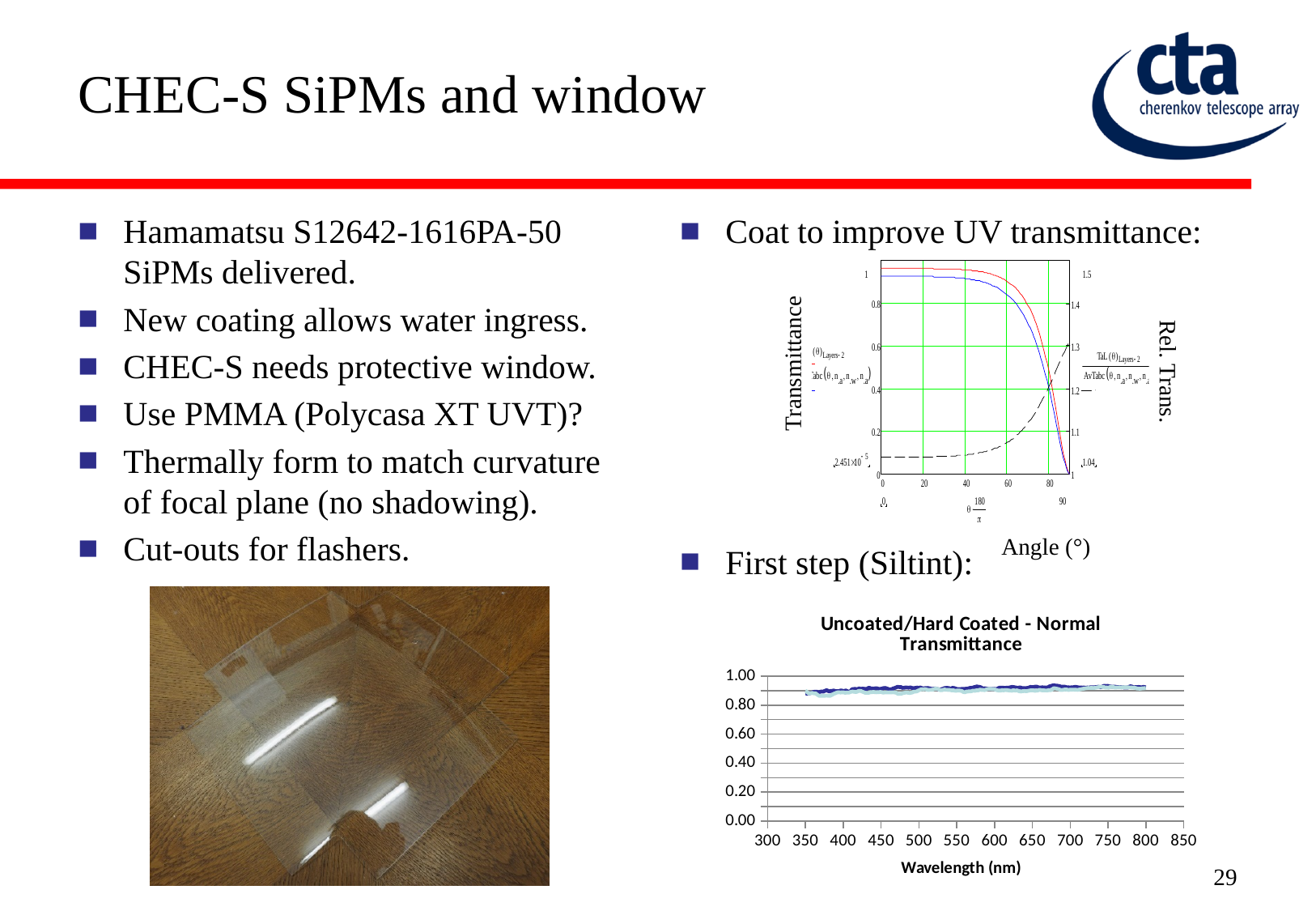
In the upper-right chart of transmittance versus angle, do the red and blue transmittance curves rise or fall as the angle increases? fall What kind of chart is the upper-right chart plotting transmittance against angle? line chart In the bottom-right chart 'Uncoated/Hard Coated - Normal Transmittance', is the transmittance at 400 nm greater or less than 0.80? greater In the bottom-right chart 'Uncoated/Hard Coated - Normal Transmittance', is the transmittance at 800 nm greater or less than 1.00? less What kind of chart is the bottom-right chart titled 'Uncoated/Hard Coated - Normal Transmittance'? line chart In the upper-right chart of transmittance versus angle, does the dashed curve (Rel. Trans.) rise or fall as the angle increases? rise In the bottom-right chart 'Uncoated/Hard Coated - Normal Transmittance', is the transmittance at 600 nm greater or less than 0.60? greater What is the title of the bottom-right chart? Uncoated/Hard Coated - Normal Transmittance In the bottom-right chart 'Uncoated/Hard Coated - Normal Transmittance', do the plotted values generally rise or fall as wavelength increases from 350 nm to 800 nm? rise In the bottom-right chart 'Uncoated/Hard Coated - Normal Transmittance', what is the x-axis label? Wavelength (nm)